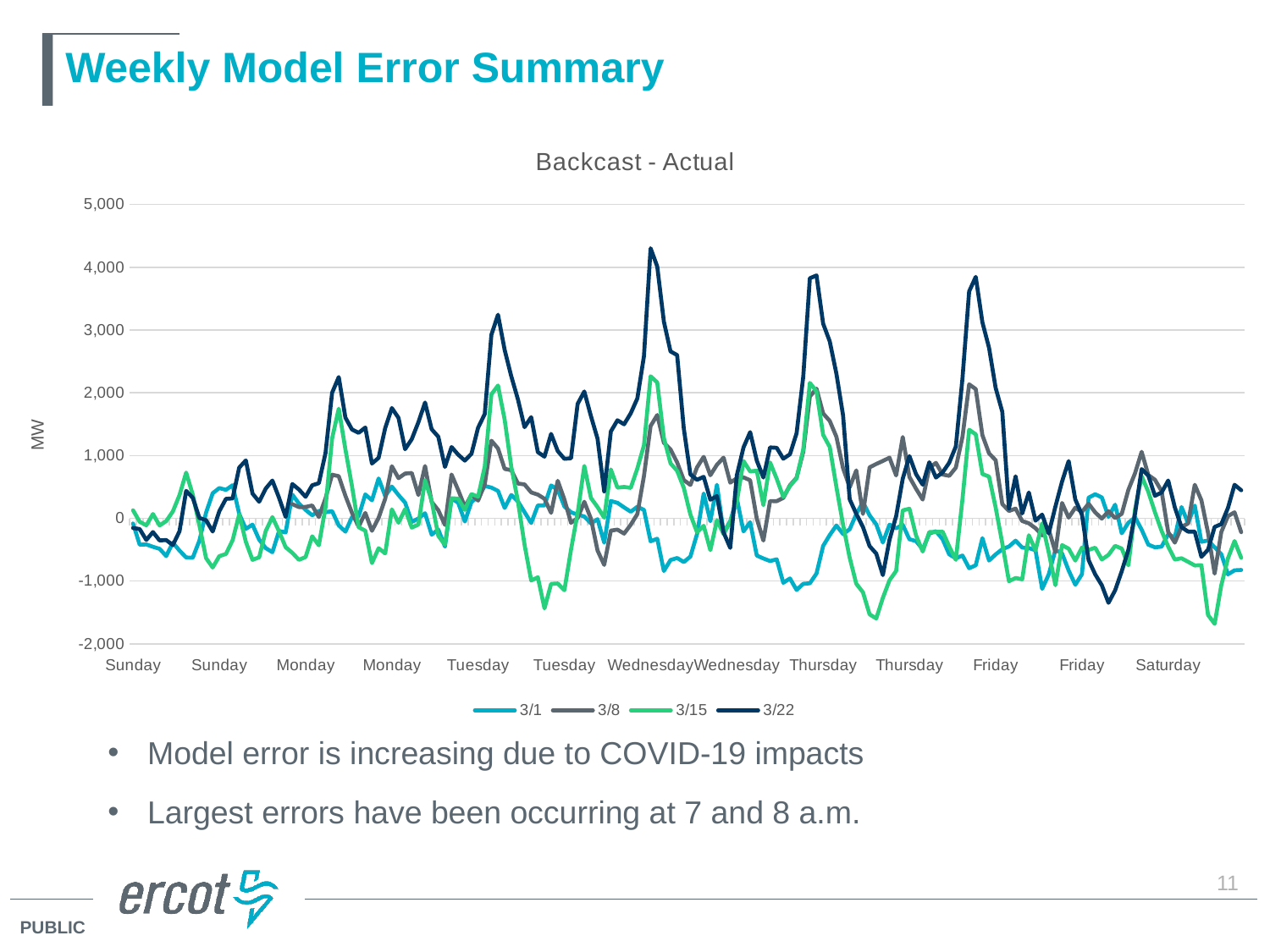
What kind of chart is shown on the slide? line chart What is the title of the chart? Backcast - Actual Is the highest peak of the 3/22 series (on Wednesday) greater or less than 4,000? greater Which series reaches the lowest value on the chart? 3/15 Is the peak of the 3/15 series on Wednesday greater or less than 2,000? greater Is the peak of the 3/22 series on Thursday greater or less than 3,000? greater Which series reaches the highest value on the chart? 3/22 How many series does the chart's legend list? 4 What unit is shown on the vertical axis label of the chart? MW Which series has the larger peak on Thursday, 3/22 or 3/8? 3/22